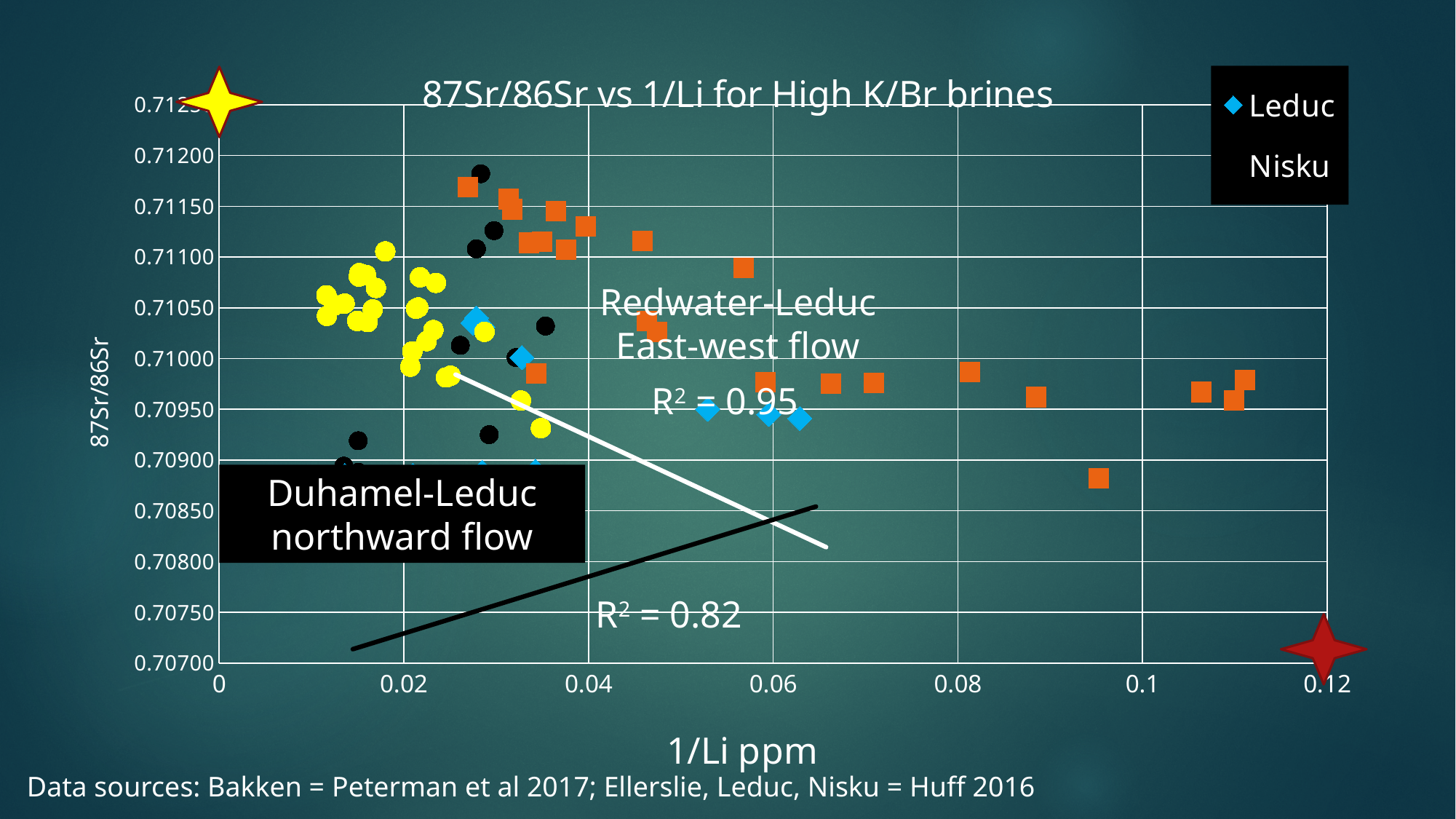
What is the lowest value shown on the y axis of the chart? 0.70700 What is the label on the x axis of the chart? 1/Li ppm What is the title of the chart? 87Sr/86Sr vs 1/Li for High K/Br brines Is the 87Sr/86Sr value of the highest Nisku point (near 1/Li of 0.027) greater or less than 0.71150? greater What R² value is shown for the Redwater-Leduc East-west flow trend line? 0.95 Which trend line has the higher R² value, Redwater-Leduc East-west flow or Duhamel-Leduc northward flow? Redwater-Leduc East-west flow What is the highest value shown on the x axis of the chart? 0.12 What is the difference between the two R² values shown on the chart? 0.13 What R² value is shown for the Duhamel-Leduc northward flow trend line? 0.82 How many series does the chart legend list? 2 Is the 87Sr/86Sr value of the Nisku point with the largest 1/Li value (near 0.11) greater or less than 0.71000? less What kind of chart is shown on the slide? Scatter chart